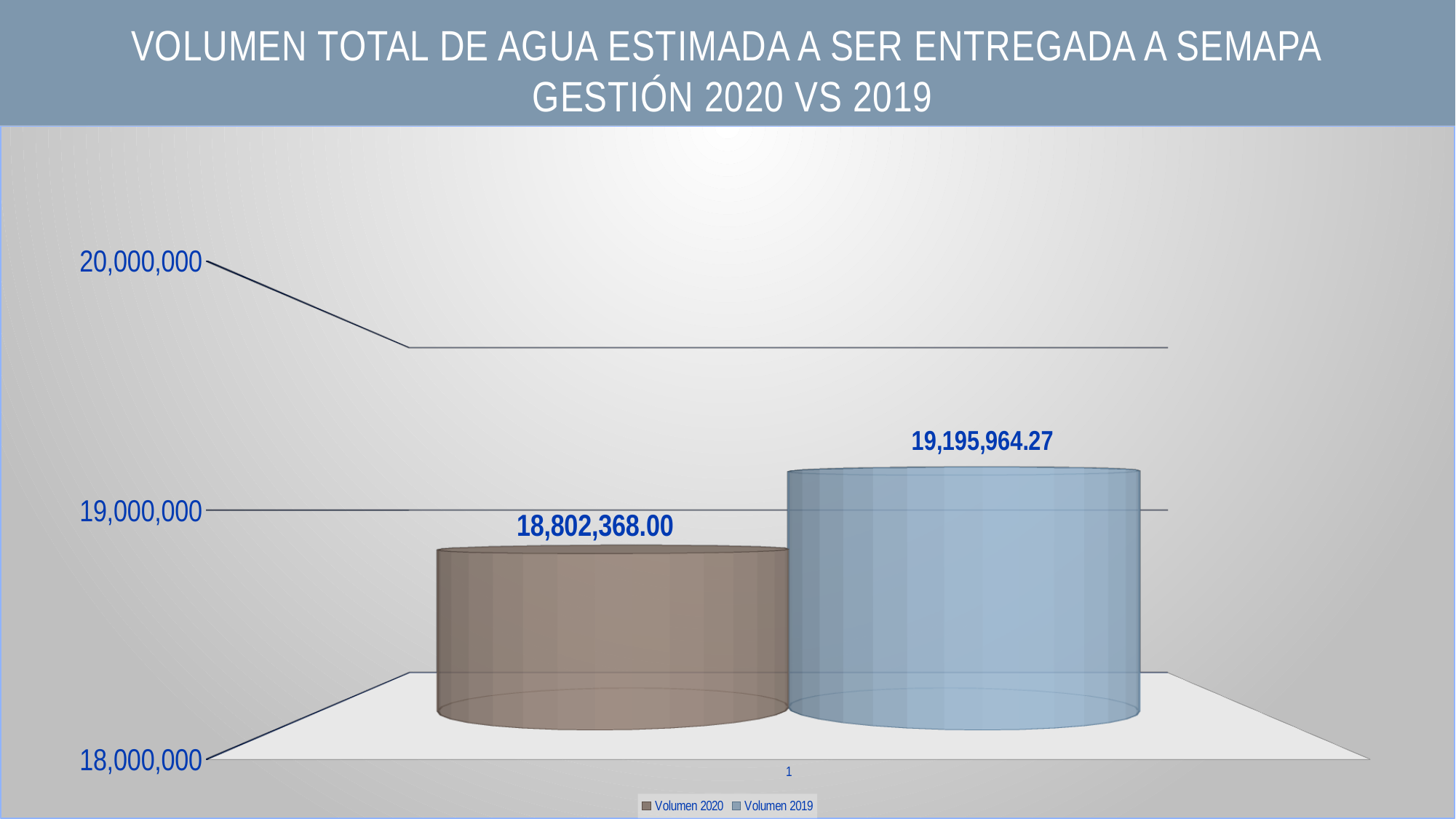
What colour is the bar for Volumen 2019? Blue Which series has the higher value, Volumen 2020 or Volumen 2019? Volumen 2019 What is the value for Volumen 2020? 18,802,368.00 Is the value for Volumen 2019 greater or less than 19,000,000? greater How many series does the legend list? 2 What is the difference between the Volumen 2019 value and the Volumen 2020 value? 393,596.27 Is the value for Volumen 2020 greater or less than 19,000,000? less What is the value for Volumen 2019? 19,195,964.27 What is the title of the chart? VOLUMEN TOTAL DE AGUA ESTIMADA A SER ENTREGADA A SEMAPA GESTIÓN 2020 VS 2019 Which series has the lowest value? Volumen 2020 What kind of chart is shown on the slide? Bar chart Which series has the highest value? Volumen 2019